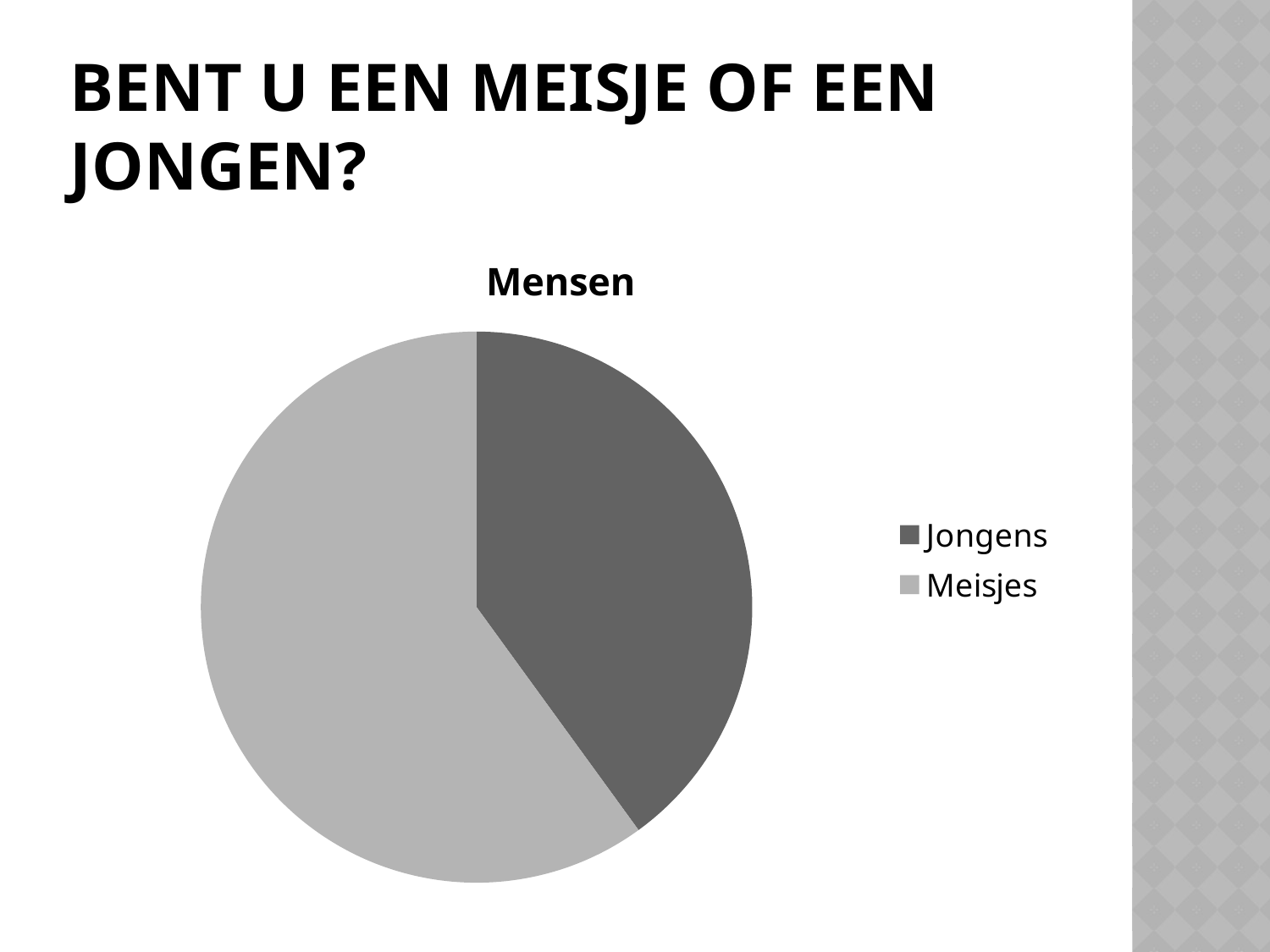
Which category has the largest slice of the pie? Meisjes Which legend entry is shown in the darker grey colour? Jongens How many slices does the pie chart have? 2 Which category has the smallest slice of the pie? Jongens What is the title of the chart? Mensen Which slice is larger, Jongens or Meisjes? Meisjes What kind of chart is shown on the slide? pie chart How many entries does the legend list? 2